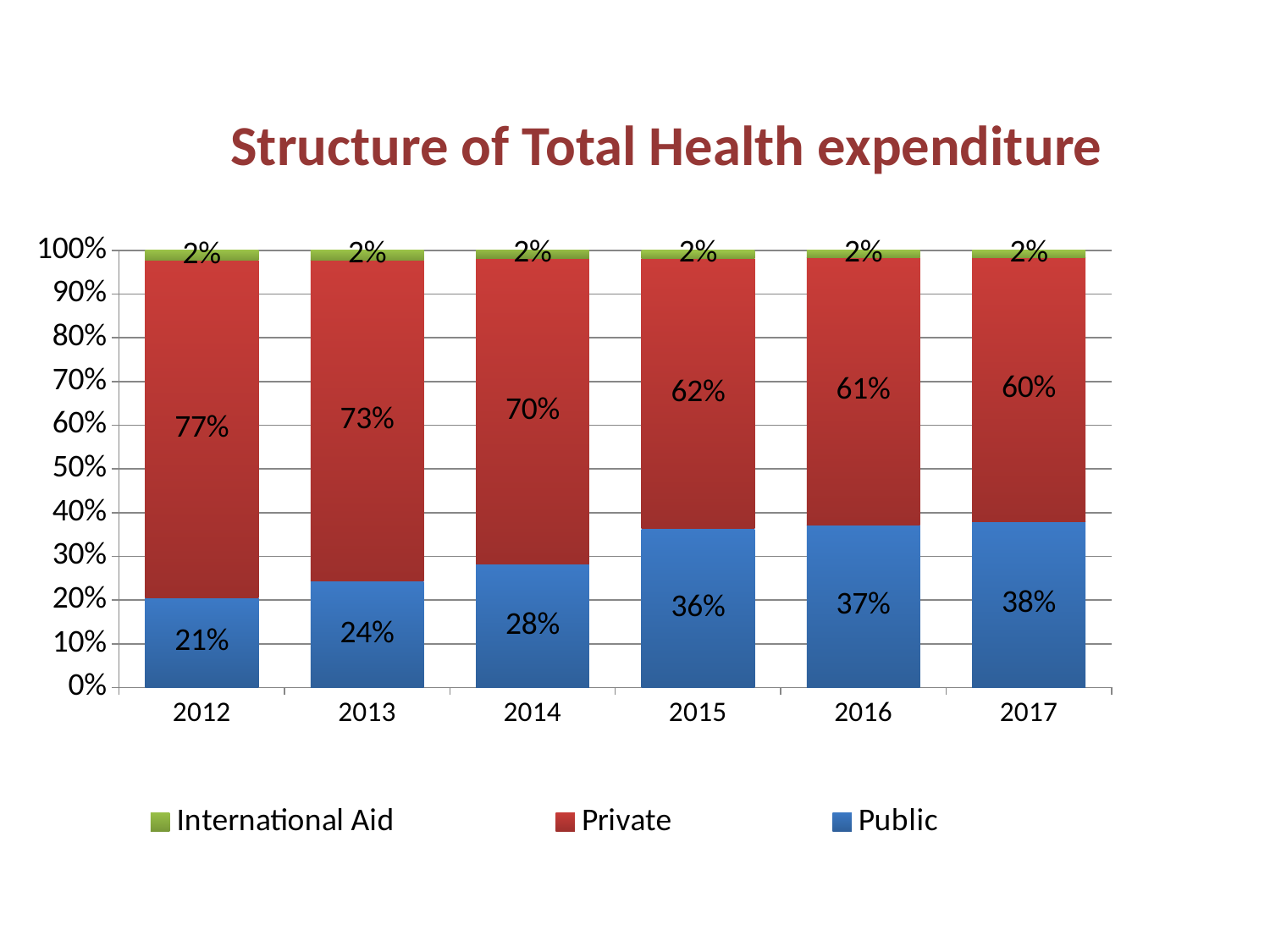
What kind of chart is shown on the slide? Stacked bar chart How many series does the legend list? 3 How many years are shown on the x axis? 6 In which year is the Public share highest? 2017 By how many percentage points did the Public share change from 2012 to 2017? 17 percentage points Does the Public share rise or fall from 2012 to 2017? Rise What is the title of the chart? Structure of Total Health expenditure What is the Public share of total health expenditure in 2012? 21% Which is larger in 2014, the Public share or the Private share? Private What is the Private share of total health expenditure in 2015? 62% What is the International Aid share in 2017? 2% In which year is the Private share lowest? 2017